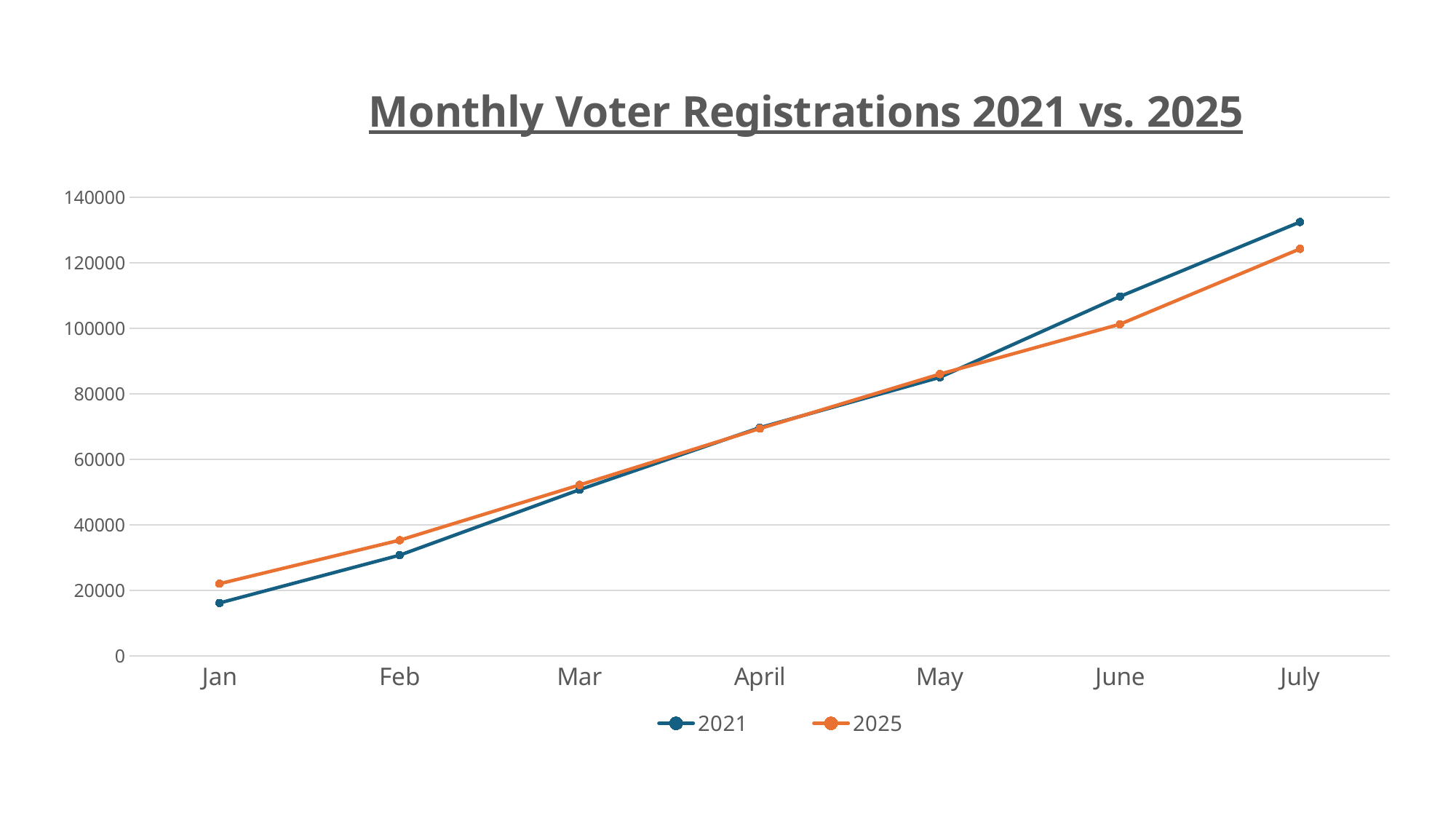
Is the 2021 value for July greater or less than 120000? greater Is the 2021 value for Jan greater or less than 20000? less How many series does the legend list? 2 In July, which series has the larger value, 2021 or 2025? 2021 Which month has the highest value for the 2025 series? July How many months are plotted along the x axis? 7 In Jan, which series has the larger value, 2021 or 2025? 2025 What is the title of the chart? Monthly Voter Registrations 2021 vs. 2025 Do the 2021 values rise or fall from Jan to July? rise What kind of chart is shown on the slide? line chart Which month has the lowest value for the 2021 series? Jan Is the 2025 value for Feb greater or less than 40000? less